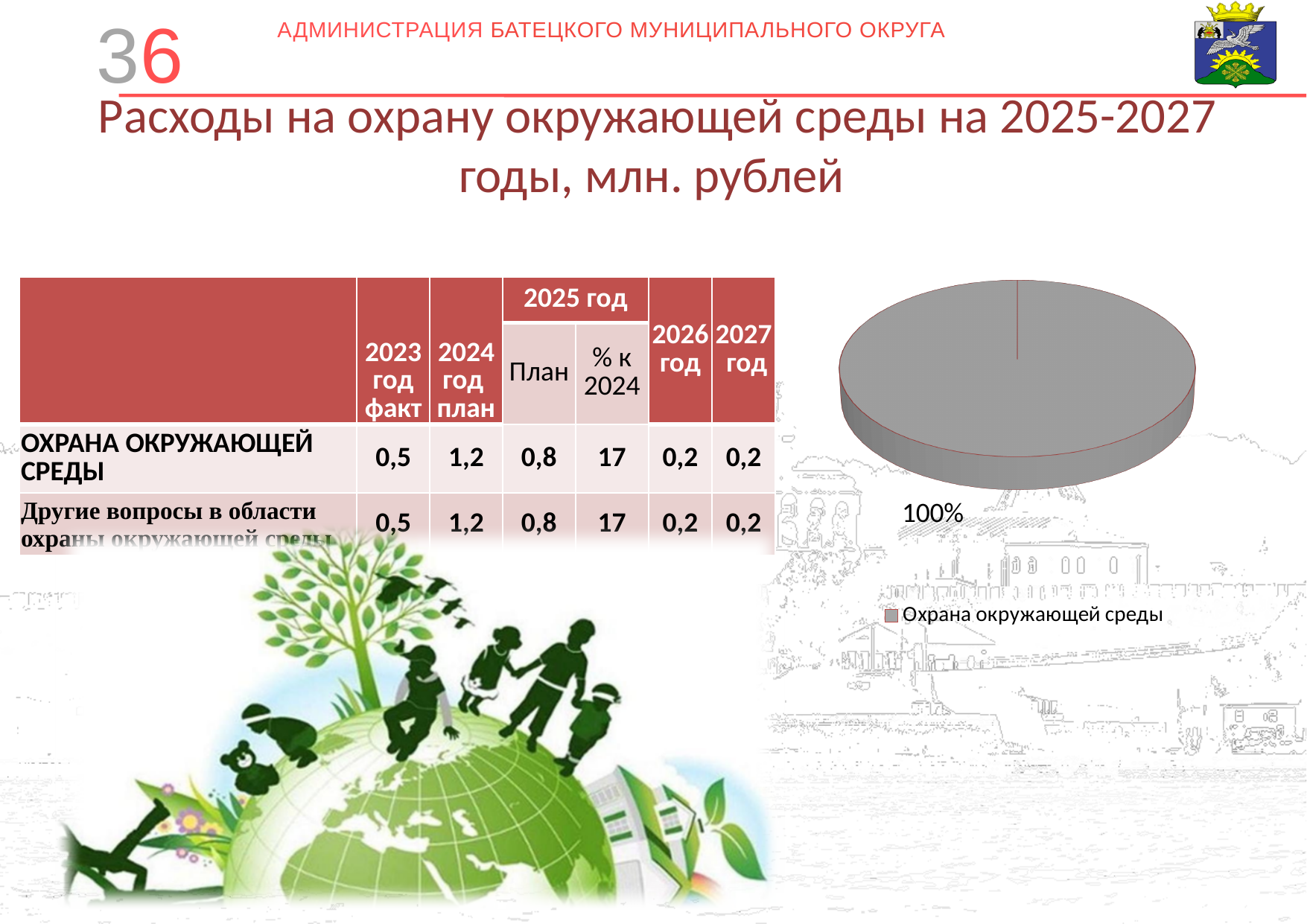
How many slices does the pie chart contain? 1 What is the legend entry of the pie chart? Охрана окружающей среды What kind of chart is shown on the right side of the slide? pie chart How many entries does the pie chart's legend list? 1 What colour is the single slice of the pie chart? grey What share of the pie chart does the slice labelled "Охрана окружающей среды" represent? 100%